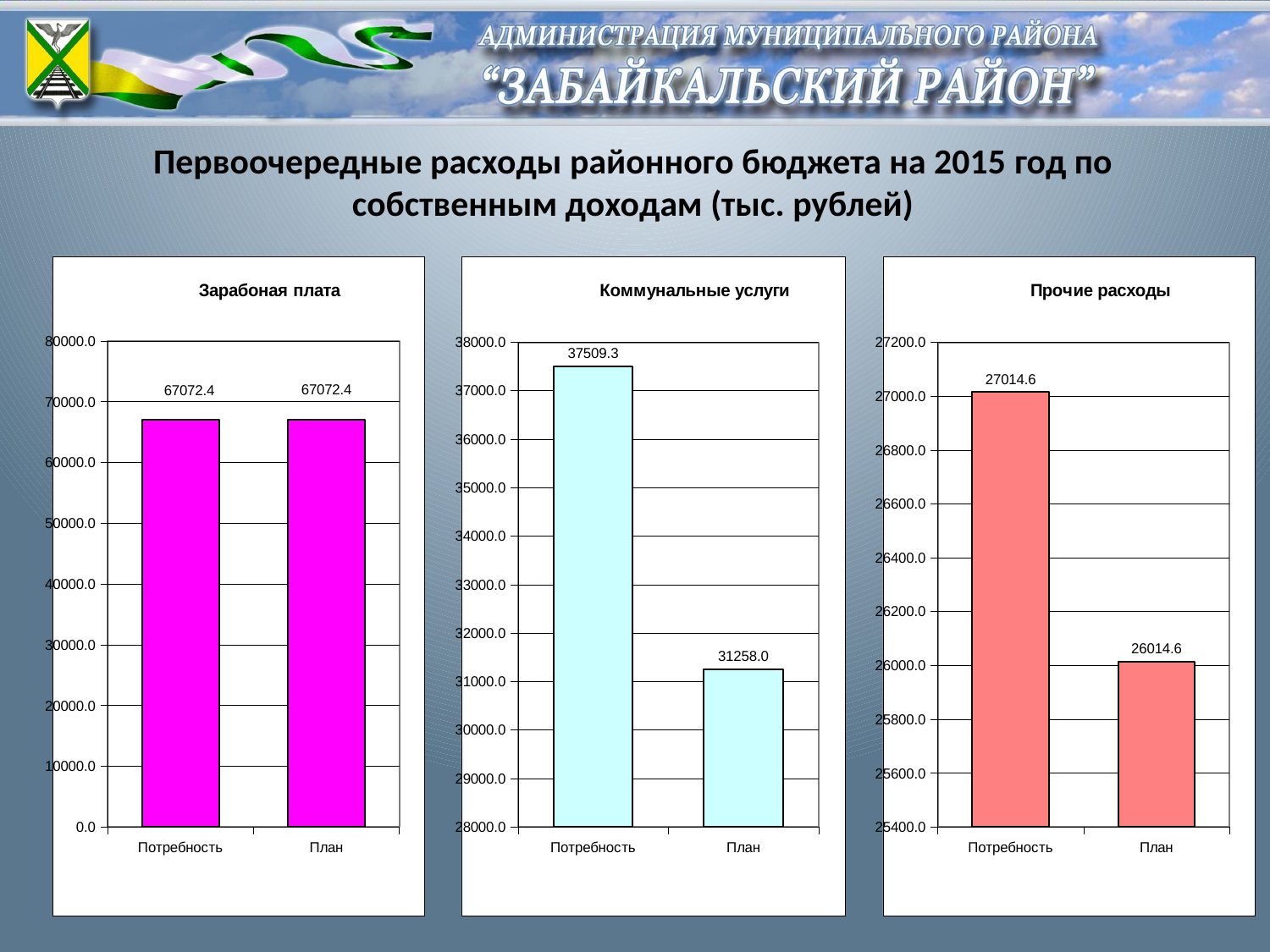
In the "Прочие расходы" chart, what is the difference between Потребность and План? 1000.0 In the "Коммунальные услуги" chart, which category has the higher value, Потребность or План? Потребность In the "Заработная плата" chart, what is the value for Потребность? 67072.4 In the "Коммунальные услуги" chart, what is the difference between Потребность and План? 6251.3 In the "Заработная плата" chart, what is the value for План? 67072.4 In the "Прочие расходы" chart, what is the value for Потребность? 27014.6 In the "Коммунальные услуги" chart, what is the value for Потребность? 37509.3 How many categories are shown in the "Заработная плата" chart? 2 In the "Прочие расходы" chart, which category has the lowest value? План In the "Прочие расходы" chart, what is the value for План? 26014.6 What type of chart is the "Коммунальные услуги" chart? Bar chart In the "Коммунальные услуги" chart, what is the value for План? 31258.0